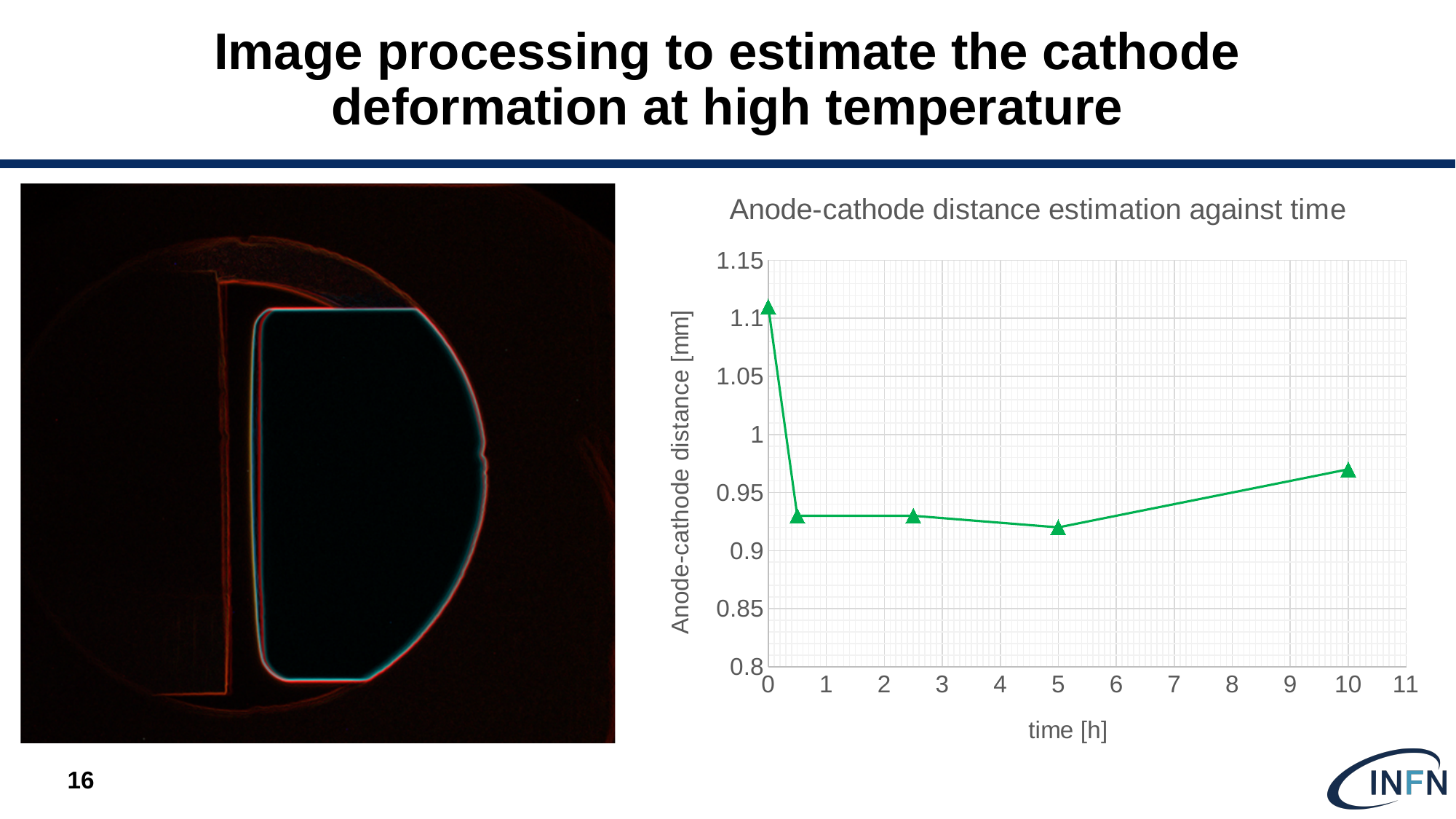
Which is larger, the anode-cathode distance at 0 h or at 10 h? 0 h At which time is the anode-cathode distance highest? 0 h Is the anode-cathode distance at time 5 h greater or less than 0.9 mm? greater Which is larger, the anode-cathode distance at 5 h or at 10 h? 10 h How many data points are plotted on the chart? 5 Is the anode-cathode distance at time 0 h greater or less than 1.05 mm? greater Does the anode-cathode distance rise or fall between 5 h and 10 h? rise Is the anode-cathode distance at time 10 h greater or less than 0.95 mm? greater What is the label of the y axis of the chart? Anode-cathode distance [mm] What kind of chart is shown on the slide? line chart What is the title of the chart? Anode-cathode distance estimation against time